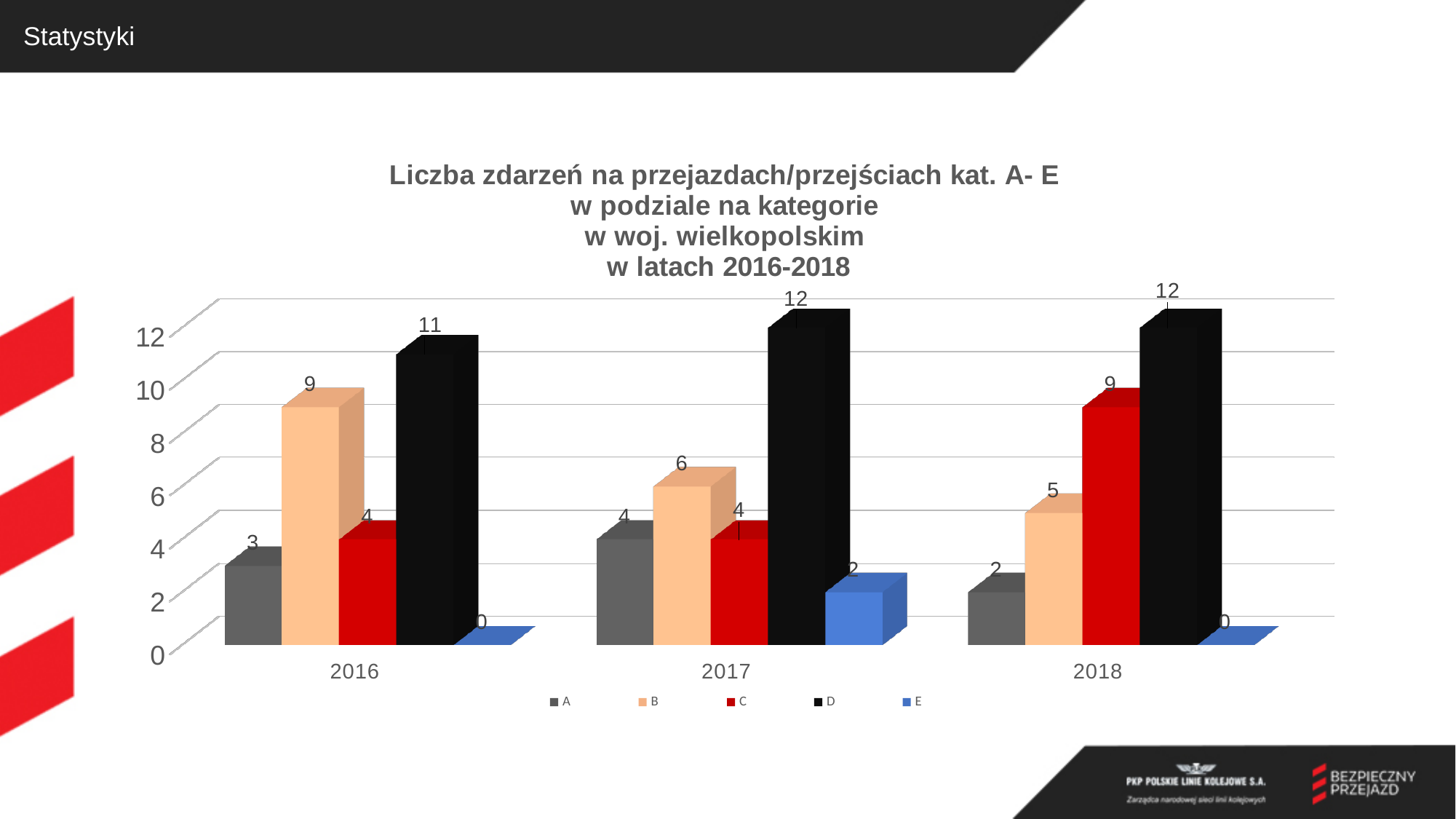
Does the value for series A rise or fall from 2017 to 2018? Fall Which is larger in 2016: series B or series C? B Which series has the lowest value in 2016? E How many years are shown on the x axis? 3 What is the difference between series D and series A in 2017? 8 How many series does the legend list? 5 What is the value for series C in 2018? 9 What is the value for series D in 2016? 11 What is the value for series E in 2017? 2 What is the value for series B in 2017? 6 Which series has the highest value in 2018? D What kind of chart is shown on the slide? Bar chart